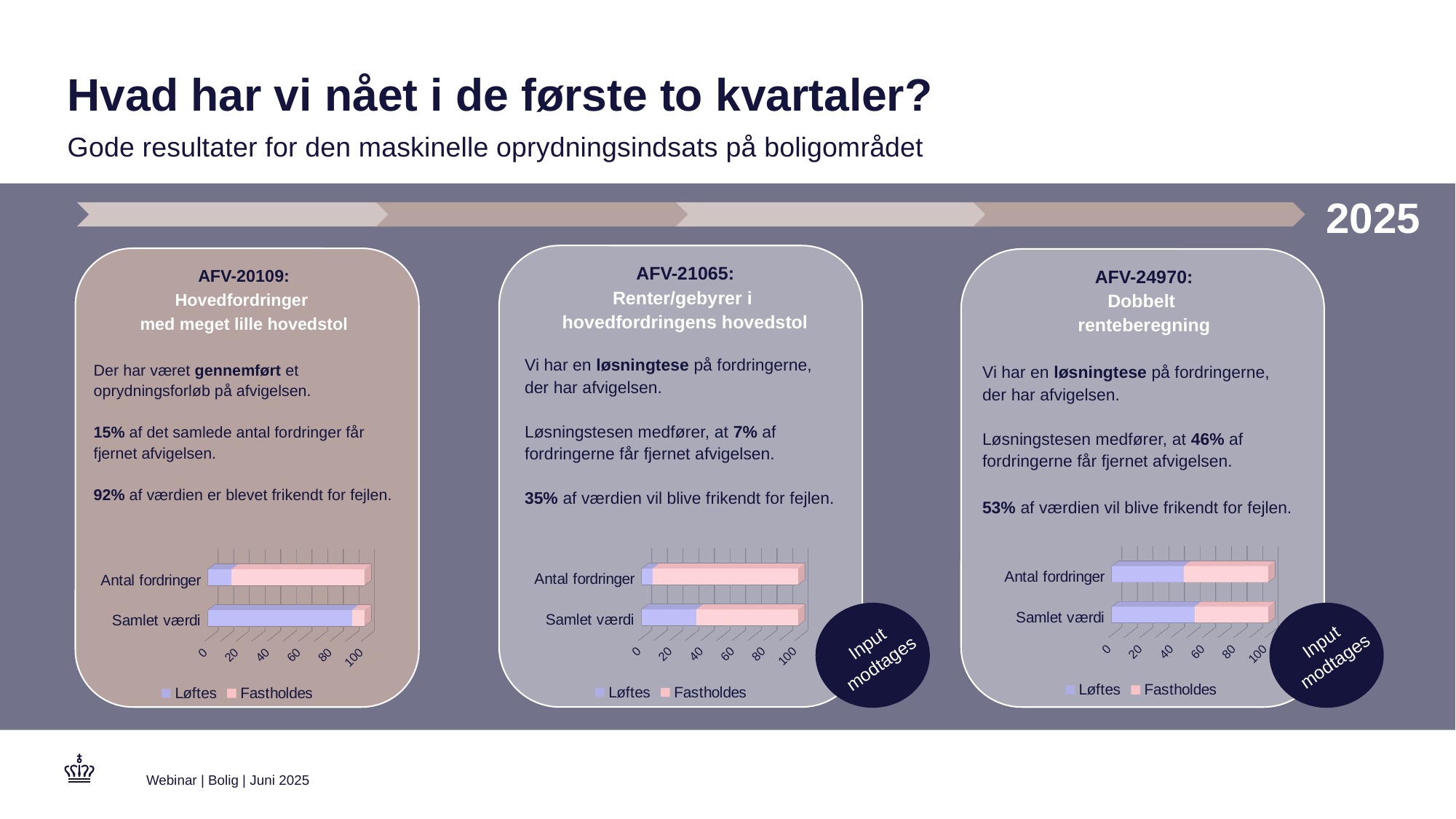
In the AFV-20109 chart, which category has the larger Løftes share: Antal fordringer or Samlet værdi? Samlet værdi In the AFV-20109 chart, is the Løftes value for Antal fordringer greater or less than 20? less In the AFV-21065 chart, which category has the larger Fastholdes share: Antal fordringer or Samlet værdi? Antal fordringer In the AFV-21065 chart, is the Løftes value for Antal fordringer greater or less than 20? less In the AFV-24970 chart, is the Løftes value for Antal fordringer greater or less than 60? less What kind of chart is shown in the AFV-20109 box? Stacked horizontal bar chart What are the two legend entries in the AFV-24970 chart? Løftes and Fastholdes How many series does the legend list in the AFV-21065 chart? 2 How many categories are plotted in the AFV-24970 chart? 2